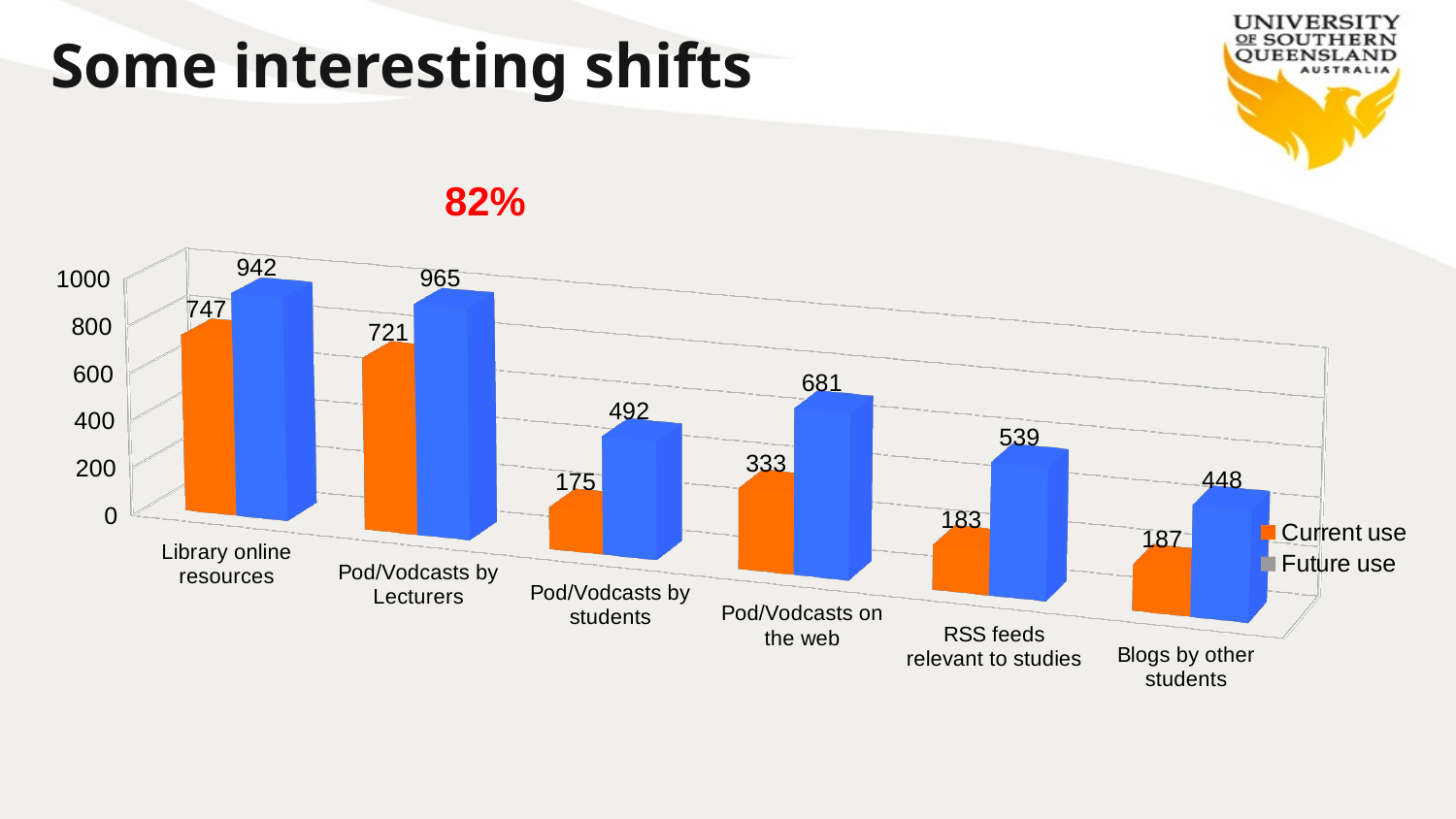
What is the Future use value for Pod/Vodcasts by Lecturers? 965 What kind of chart is shown on the slide? bar chart Which colour represents Future use in the chart? blue How many categories are shown on the x axis? 6 Is the Future use value for RSS feeds relevant to studies greater or less than 400? greater Which category has the lowest Current use value? Pod/Vodcasts by students What is the Future use value for Blogs by other students? 448 How many series does the legend list? 2 What is the difference between Future use and Current use for Pod/Vodcasts on the web? 348 Which is larger: the Current use value for RSS feeds relevant to studies or the Current use value for Pod/Vodcasts on the web? Pod/Vodcasts on the web What is the Current use value for Library online resources? 747 Which category has the highest Future use value? Pod/Vodcasts by Lecturers